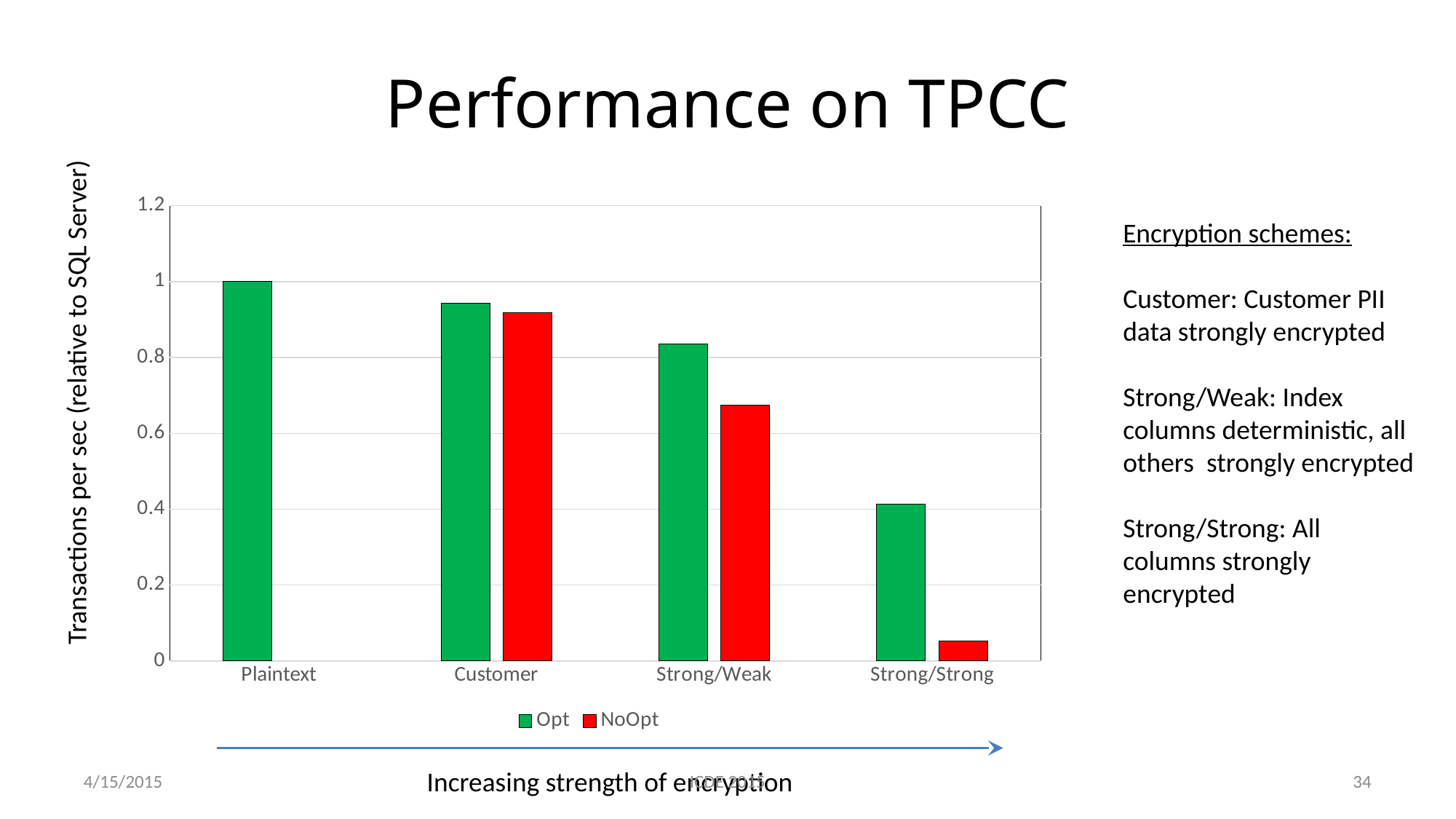
Which category has the lowest NoOpt value? Strong/Strong Do the Opt values rise or fall from Plaintext to Strong/Strong along the x axis? fall How many categories are shown on the x axis of the chart? 4 What is the title of the chart? Performance on TPCC Which category has the highest Opt value? Plaintext Is the NoOpt value for Strong/Weak greater or less than 0.8? less What colour represents the NoOpt series in the chart? red What kind of chart is shown on the slide? bar chart Which is larger for Strong/Weak, the Opt value or the NoOpt value? Opt What is the Opt value for Plaintext? 1 How many series does the chart's legend list? 2 Is the Opt value for Strong/Strong greater or less than 0.2? greater